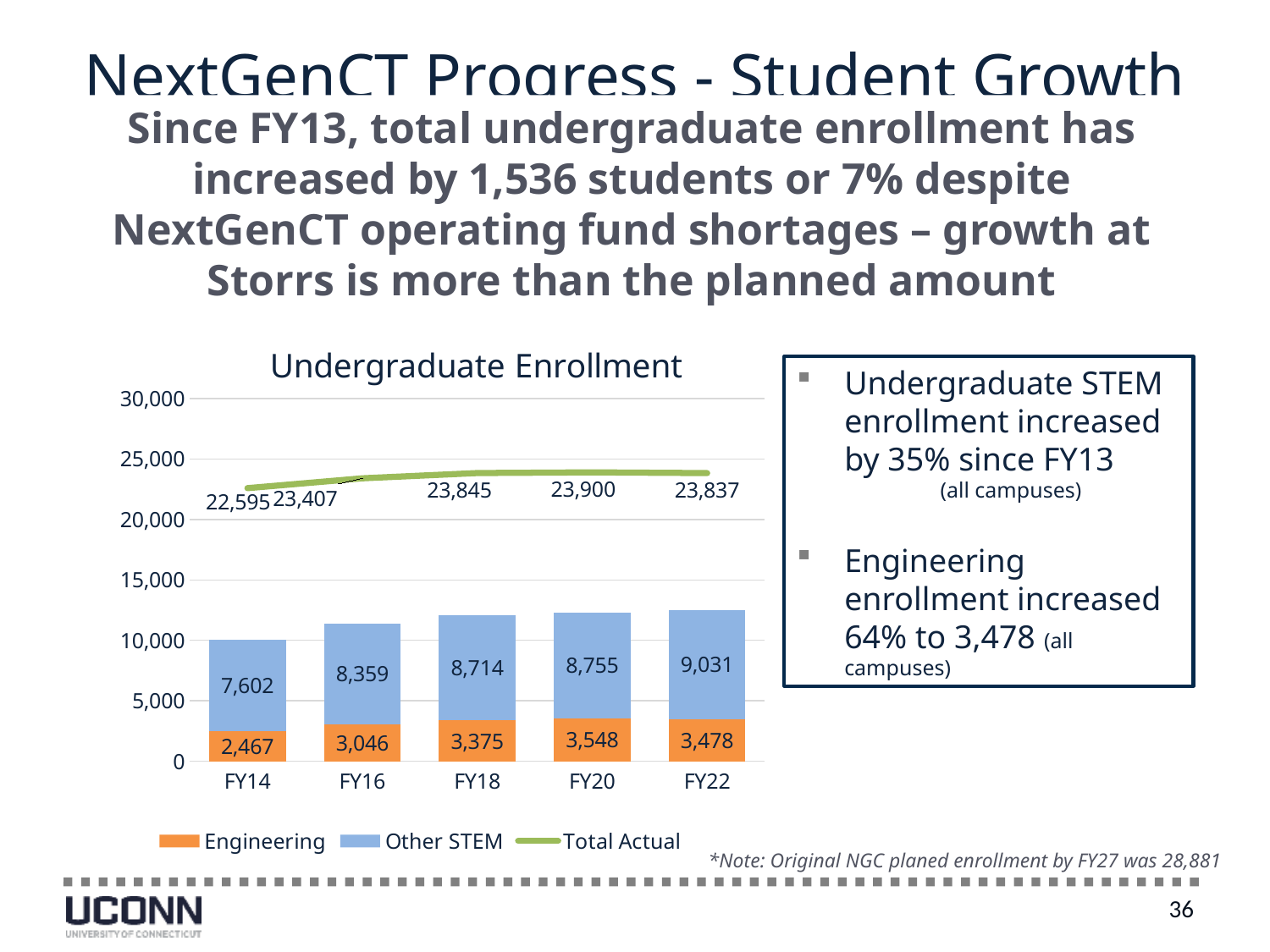
Which is larger, the Engineering enrollment in FY20 or in FY22? FY20 Does the Other STEM enrollment rise or fall from FY14 to FY22? rise What is the Total Actual enrollment value for FY18? 23,845 What is the Other STEM enrollment for FY22? 9,031 What is the combined Engineering and Other STEM enrollment in the FY16 stacked bar? 11,405 What is the difference between Other STEM enrollment in FY22 and FY14? 1,429 What is the Engineering enrollment for FY14 in the Undergraduate Enrollment chart? 2,467 How many series does the chart legend list? 3 How many fiscal years are shown on the x axis of the chart? 5 Is the Total Actual value for FY20 greater or less than 20,000? greater Which fiscal year has the lowest Total Actual enrollment? FY14 Which fiscal year has the highest Engineering enrollment? FY20